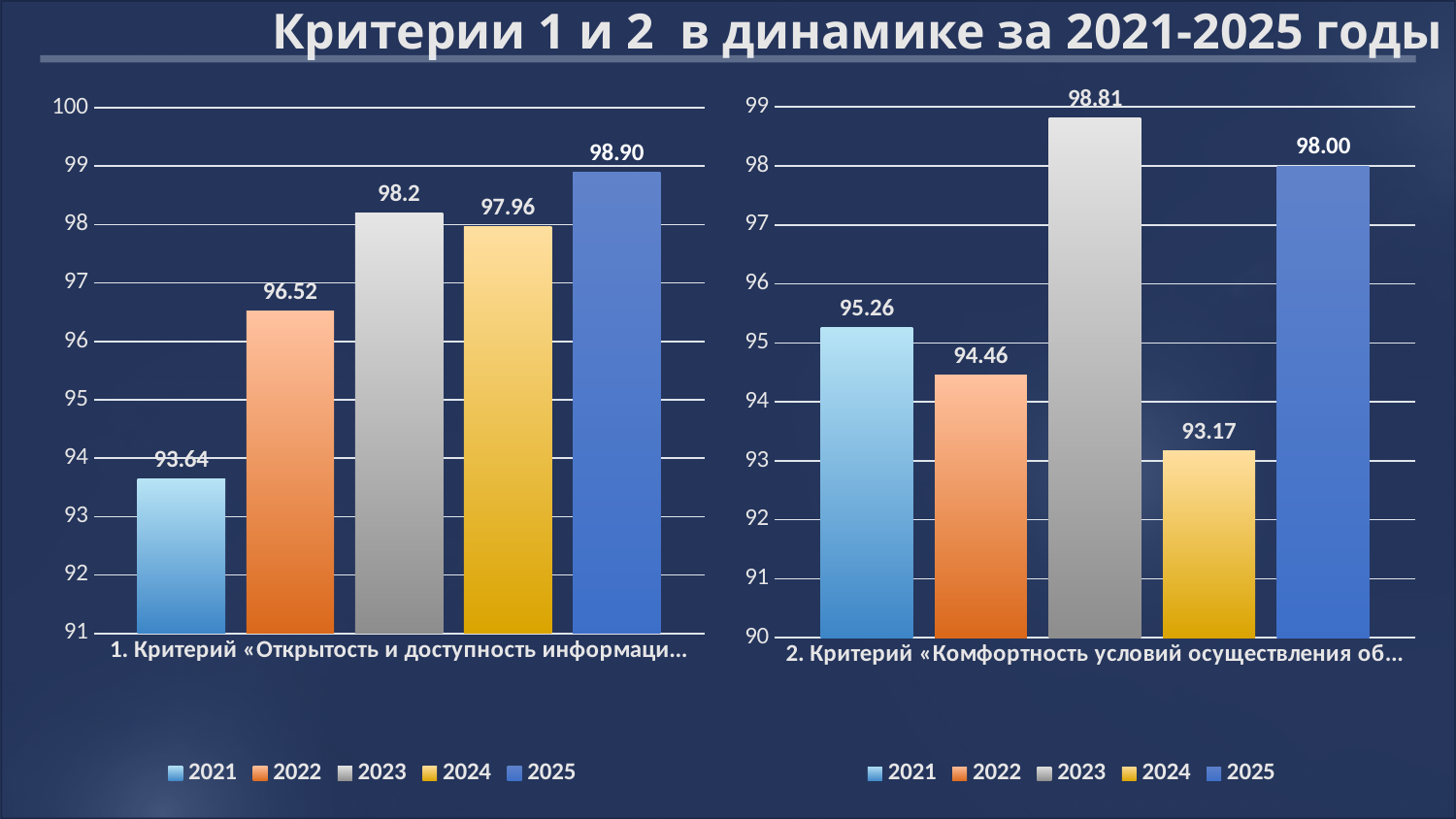
In the right chart (Criterion 2), what is the value for 2023? 98.81 In the right chart (Criterion 2), is the value for 2025 greater or less than 97? greater How many series does the legend of the left chart list? 5 In the right chart (Criterion 2), what is the difference between the 2023 value and the 2025 value? 0.81 In the left chart (Criterion 1), which year has the highest value? 2025 In the right chart (Criterion 2), what is the value for 2024? 93.17 What kind of chart is the right chart (Criterion 2)? bar chart In the left chart (Criterion 1), what is the difference between the 2025 value and the 2021 value? 5.26 In the right chart (Criterion 2), which year has the lowest value? 2024 In the right chart (Criterion 2), which is larger, the value for 2021 or the value for 2022? 2021 In the left chart (Criterion 1), what is the value for 2021? 93.64 In the left chart (Criterion 1), what is the value for 2025? 98.90